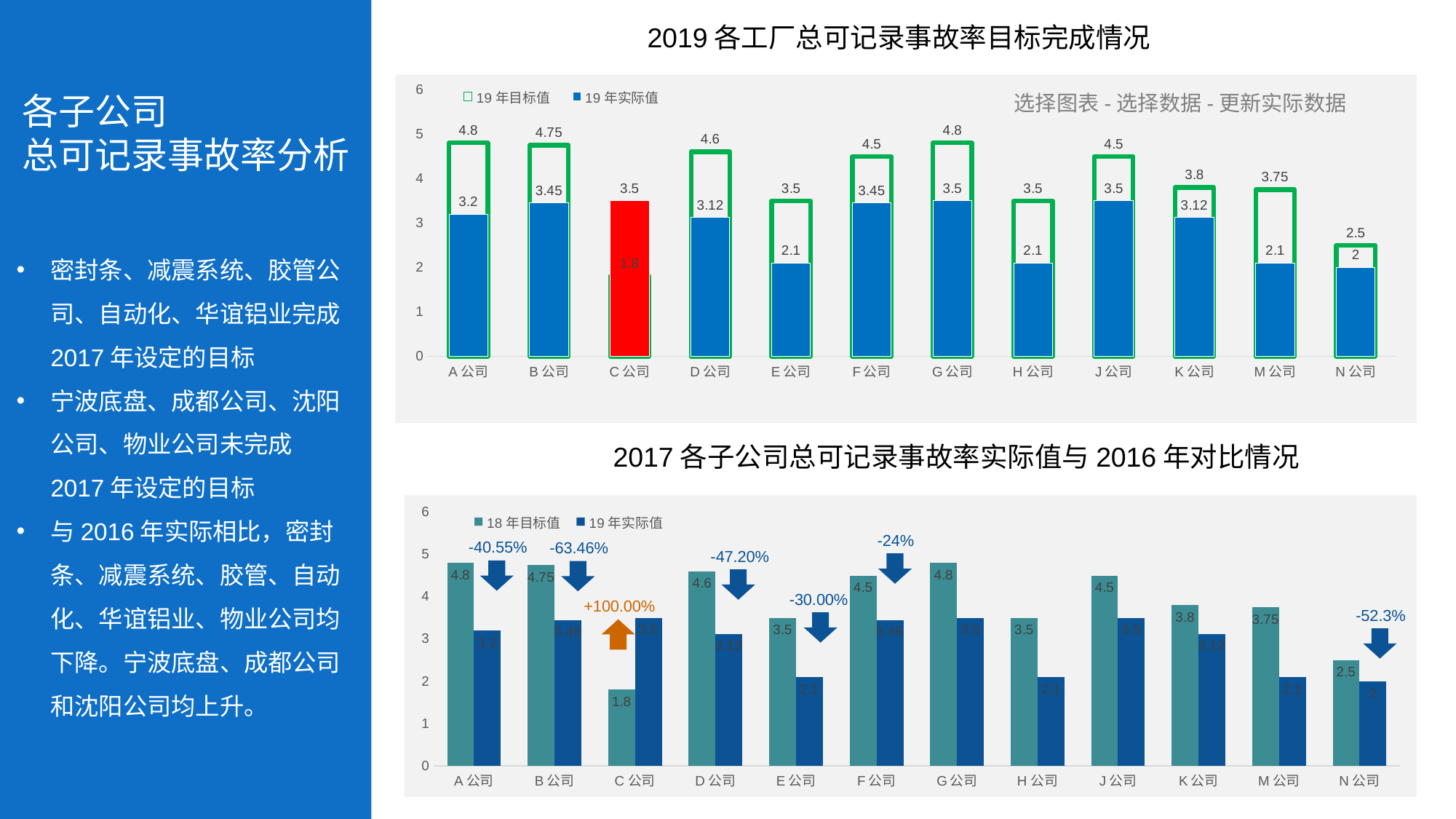
In the top chart (2019 各工厂总可记录事故率目标完成情况), what is the difference between the 19 年目标值 and the 19 年实际值 for A 公司? 1.6 In the bottom chart (2017 各子公司总可记录事故率实际值与 2016 年对比情况), what percentage change is labelled above B 公司? -63.46% In the top chart (2019 各工厂总可记录事故率目标完成情况), how many series does the legend list? 2 In the top chart (2019 各工厂总可记录事故率目标完成情况), how many companies are shown on the x axis? 12 What kind of chart is the bottom chart (2017 各子公司总可记录事故率实际值与 2016 年对比情况)? Bar chart In the bottom chart (2017 各子公司总可记录事故率实际值与 2016 年对比情况), what is the 18 年目标值 for M 公司? 3.75 In the top chart (2019 各工厂总可记录事故率目标完成情况), which has the larger 19 年实际值, B 公司 or D 公司? B 公司 In the top chart (2019 各工厂总可记录事故率目标完成情况), which company has the lowest 19 年目标值? C 公司 In the top chart (2019 各工厂总可记录事故率目标完成情况), what is the 19 年目标值 for K 公司? 3.8 In the top chart (2019 各工厂总可记录事故率目标完成情况), which company's actual-value bar is coloured red? C 公司 In the top chart (2019 各工厂总可记录事故率目标完成情况), what is the 19 年实际值 for D 公司? 3.12 In the top chart (2019 各工厂总可记录事故率目标完成情况), which company has the lowest 19 年实际值? N 公司